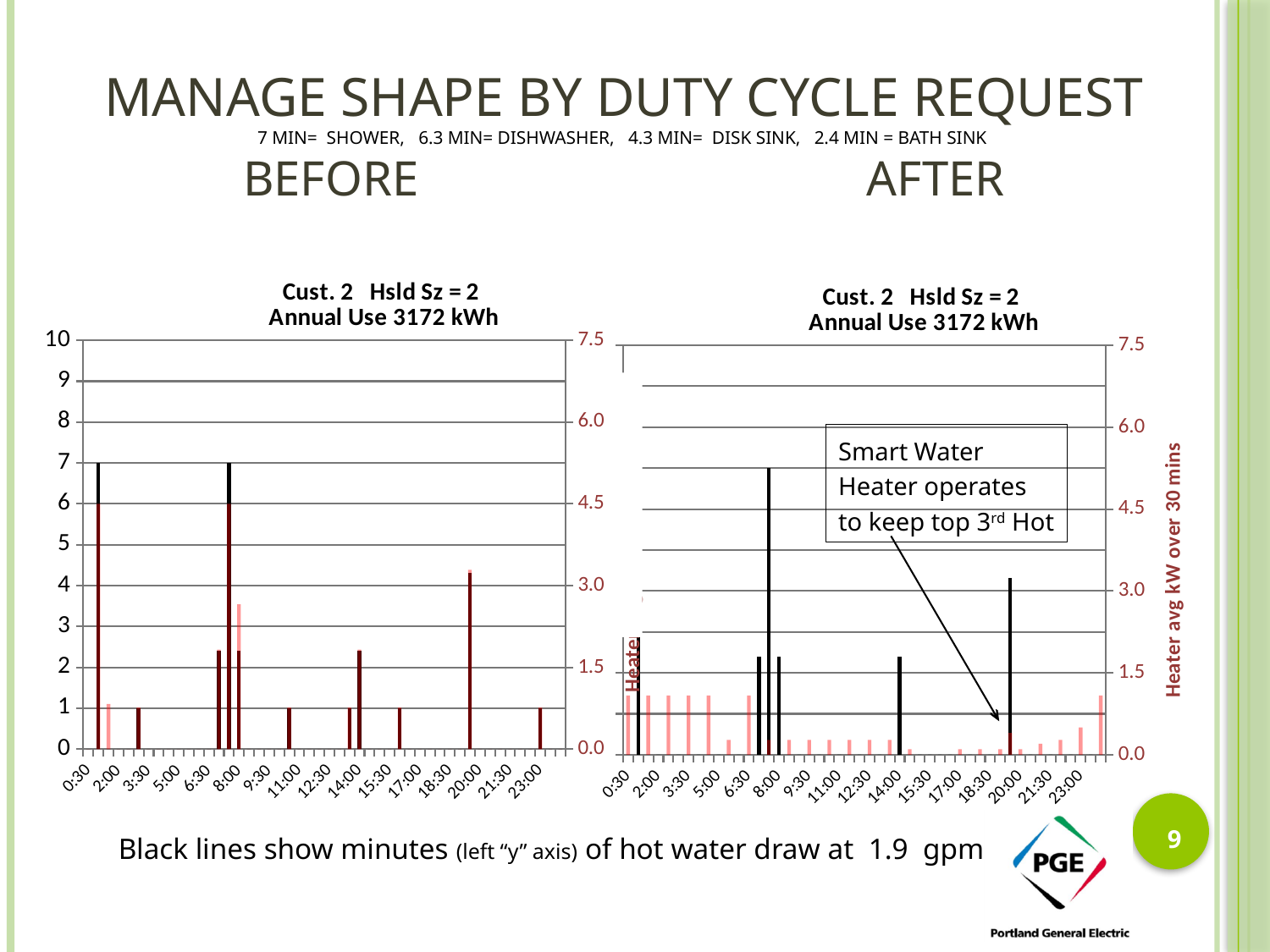
In the BEFORE chart, which is taller, the black bar at 0:30 or the black bar at 3:30? 0:30 In the BEFORE chart, is the black bar at 20:00 greater or less than 3 on the left axis? greater In the BEFORE chart, is the black bar at 3:30 greater or less than 2 on the left axis? less In the BEFORE chart, is the black bar at 0:30 greater or less than 5 on the left axis? greater What is the highest value shown on the right-hand axis of the AFTER chart? 7.5 What is the label on the right-hand vertical axis of the AFTER chart? Heater avg kW over 30 mins In the AFTER chart, which is taller, the black bar near 8:00 or the black bar near 20:00? 8:00 What kind of chart is the BEFORE chart on the left? bar chart